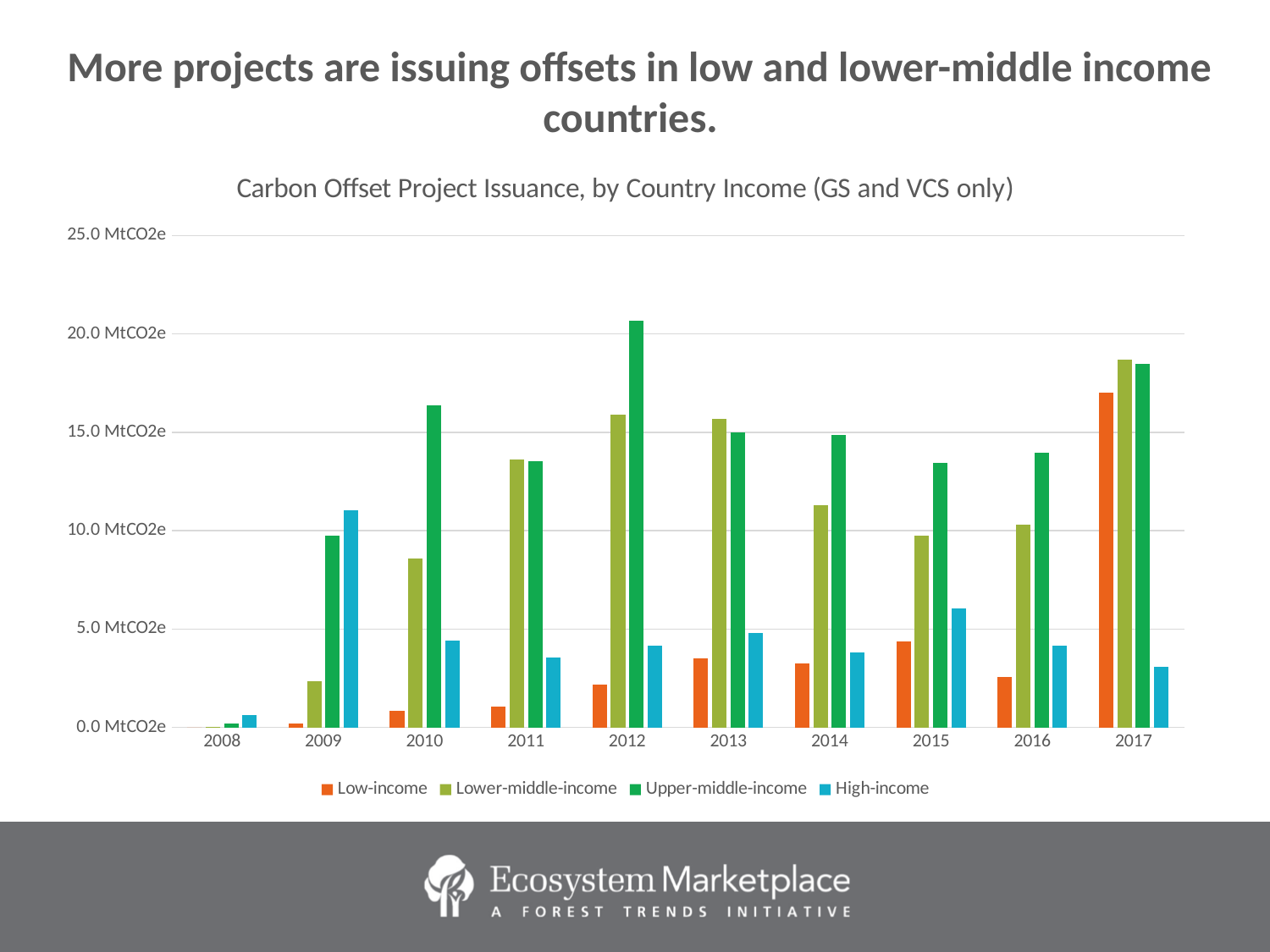
Is the High-income value for 2016 greater or less than 5.0 MtCO2e? less In 2015, which is larger: the Lower-middle-income value or the High-income value? Lower-middle-income What kind of chart is shown on the slide? Bar chart How many series does the legend list? 4 What is the title of the chart? Carbon Offset Project Issuance, by Country Income (GS and VCS only) In which year is the Low-income bar the highest? 2017 Is the Upper-middle-income value for 2012 greater or less than 20.0 MtCO2e? greater In 2010, which is larger: the Upper-middle-income value or the High-income value? Upper-middle-income In which year is the Upper-middle-income bar the highest? 2012 How many years are shown on the x axis? 10 In which year is the High-income bar the highest? 2009 Is the Low-income value for 2017 greater or less than 15.0 MtCO2e? greater